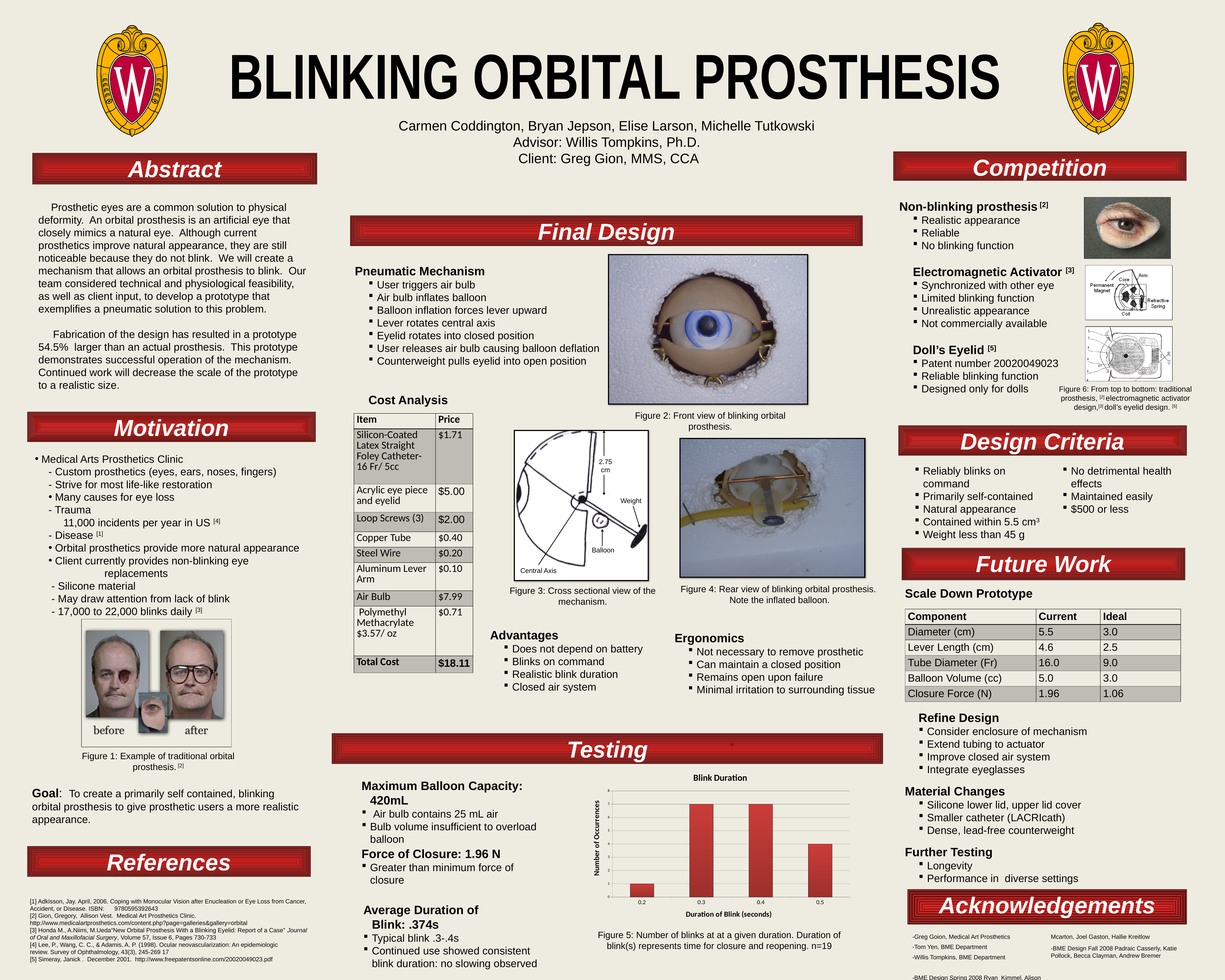
In the Blink Duration chart, what is the number of occurrences for a blink duration of 0.3 seconds? 7 In the Blink Duration chart, how many blink duration categories are shown on the x axis? 4 What type of chart is the Blink Duration chart in the Testing section? bar chart In the Blink Duration chart, is the number of occurrences for a blink duration of 0.4 seconds greater or less than 5? greater In the Blink Duration chart, what is the difference in number of occurrences between a blink duration of 0.5 seconds and 0.2 seconds? 3 What is the label of the y axis on the Blink Duration chart? Number of Occurrences In the Blink Duration chart, what is the number of occurrences for a blink duration of 0.2 seconds? 1 In the Blink Duration chart, which blink duration has the lowest number of occurrences? 0.2 In the Blink Duration chart, is the number of occurrences for a blink duration of 0.5 seconds greater or less than 6? less In the Blink Duration chart, which has more occurrences: a blink duration of 0.5 seconds or 0.2 seconds? 0.5 What is the label of the x axis on the Blink Duration chart? Duration of Blink (seconds) In the Blink Duration chart, what is the number of occurrences for a blink duration of 0.5 seconds? 4